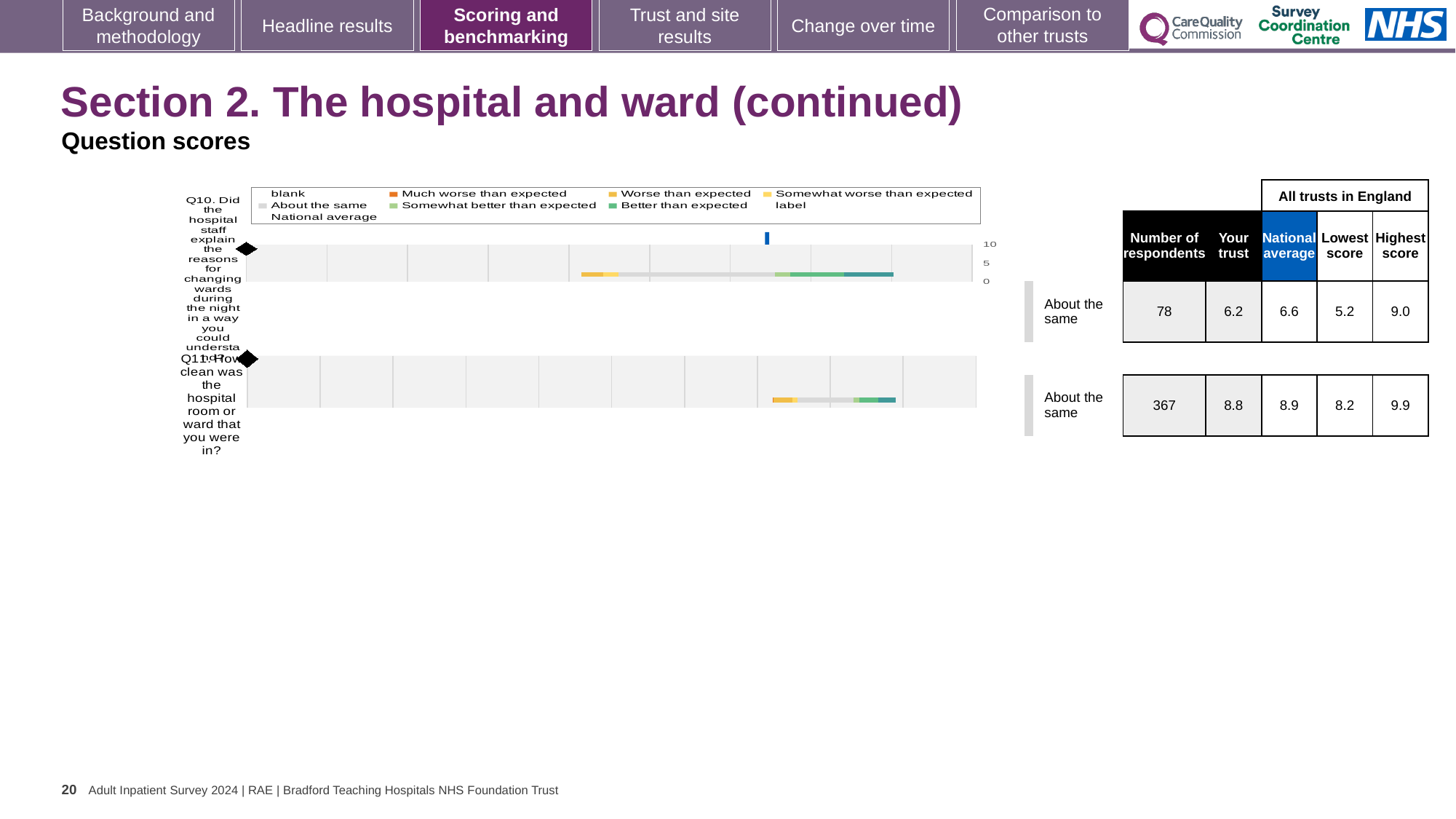
For Q11, which is larger: the 'Your trust' score or the national average? National average For Q11, how much higher is the 'Your trust' score than the lowest score across all trusts in England? 0.6 For Q10, what is the difference between the highest score and the lowest score across all trusts in England? 3.8 What benchmark category is shown for Q10 (explaining reasons for changing wards during the night)? About the same How many questions are plotted in the chart on this slide? 2 What is the highest score across all trusts in England for Q11 (how clean was the hospital room or ward)? 9.9 Which question has more respondents, Q10 or Q11? Q11 What is the 'Your trust' score for Q10 (explaining reasons for changing wards during the night)? 6.2 What kind of chart is used to show the question scores for Q10 and Q11? bar chart In the chart legend, which entry is shown with the light grey colour? About the same For Q10 (explaining reasons for changing wards during the night), how many respondents are shown? 78 What is the national average score for Q11 (how clean was the hospital room or ward)? 8.9